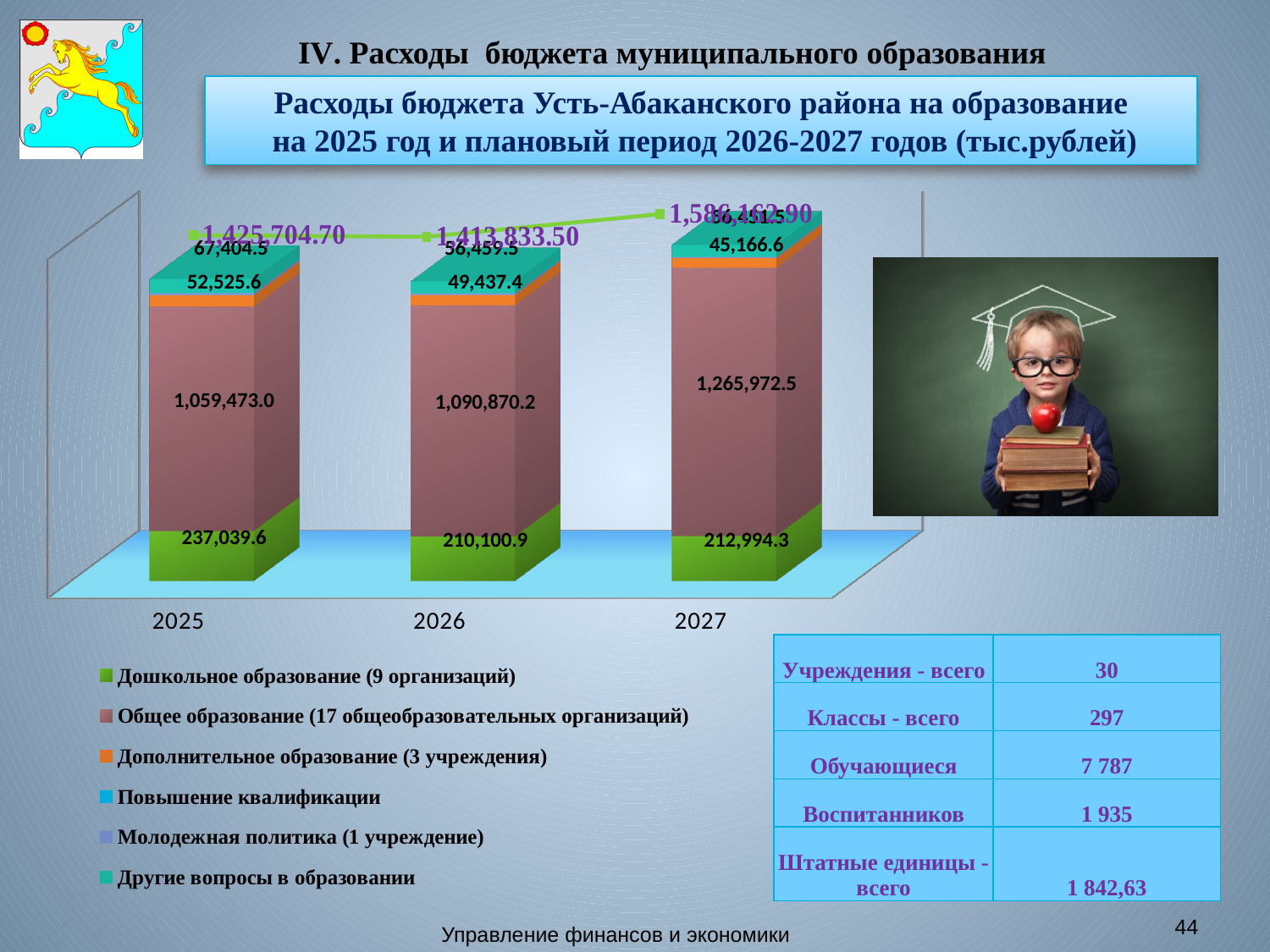
In which year is the value for Общее образование the highest? 2027 What is the value for Общее образование in 2026? 1,090,870.2 What is the value for Общее образование in 2027? 1,265,972.5 What is the value for Дошкольное образование in 2025? 237,039.6 Which year has the lowest total shown above the bars? 2026 What kind of chart is shown on the slide? stacked bar chart Do the values for Общее образование rise or fall from 2025 to 2027? rise What is the difference between the Общее образование values for 2027 and 2025? 206,499.5 How many years (categories) are shown on the x axis of the chart? 3 How many series does the chart legend list? 6 What total is shown above the bar for 2027? 1,586,162.90 Which year has the larger value for Дошкольное образование, 2025 or 2026? 2025